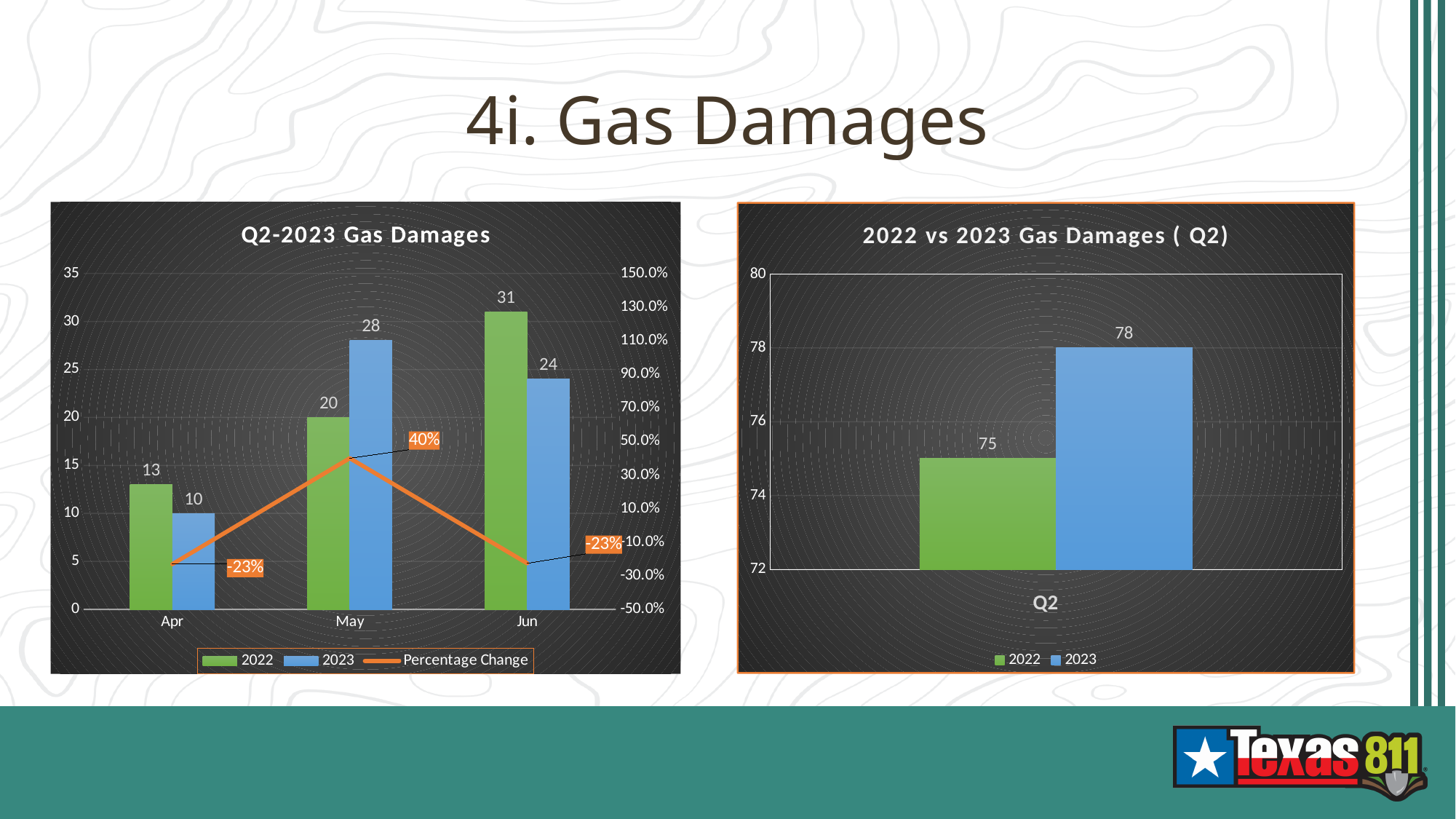
In the 'Q2-2023 Gas Damages' chart, what is the difference between the 2022 and 2023 values for Jun? 7 In the '2022 vs 2023 Gas Damages ( Q2)' chart, what is the value for 2023? 78 In the 'Q2-2023 Gas Damages' chart, what is the 2022 value for Jun? 31 In the 'Q2-2023 Gas Damages' chart, which month has the lowest 2023 value? Apr In the 'Q2-2023 Gas Damages' chart, what is the 2023 value for May? 28 In the '2022 vs 2023 Gas Damages ( Q2)' chart, what is the difference between the 2023 and 2022 values? 3 What kind of chart is the '2022 vs 2023 Gas Damages ( Q2)' chart? Bar chart How many series does the legend of the 'Q2-2023 Gas Damages' chart list? 3 In the 'Q2-2023 Gas Damages' chart, what is the Percentage Change for May? 40% In the 'Q2-2023 Gas Damages' chart, which is larger for Apr: the 2022 value or the 2023 value? 2022 In the 'Q2-2023 Gas Damages' chart, which month has the highest 2022 value? Jun How many months are shown on the x axis of the 'Q2-2023 Gas Damages' chart? 3